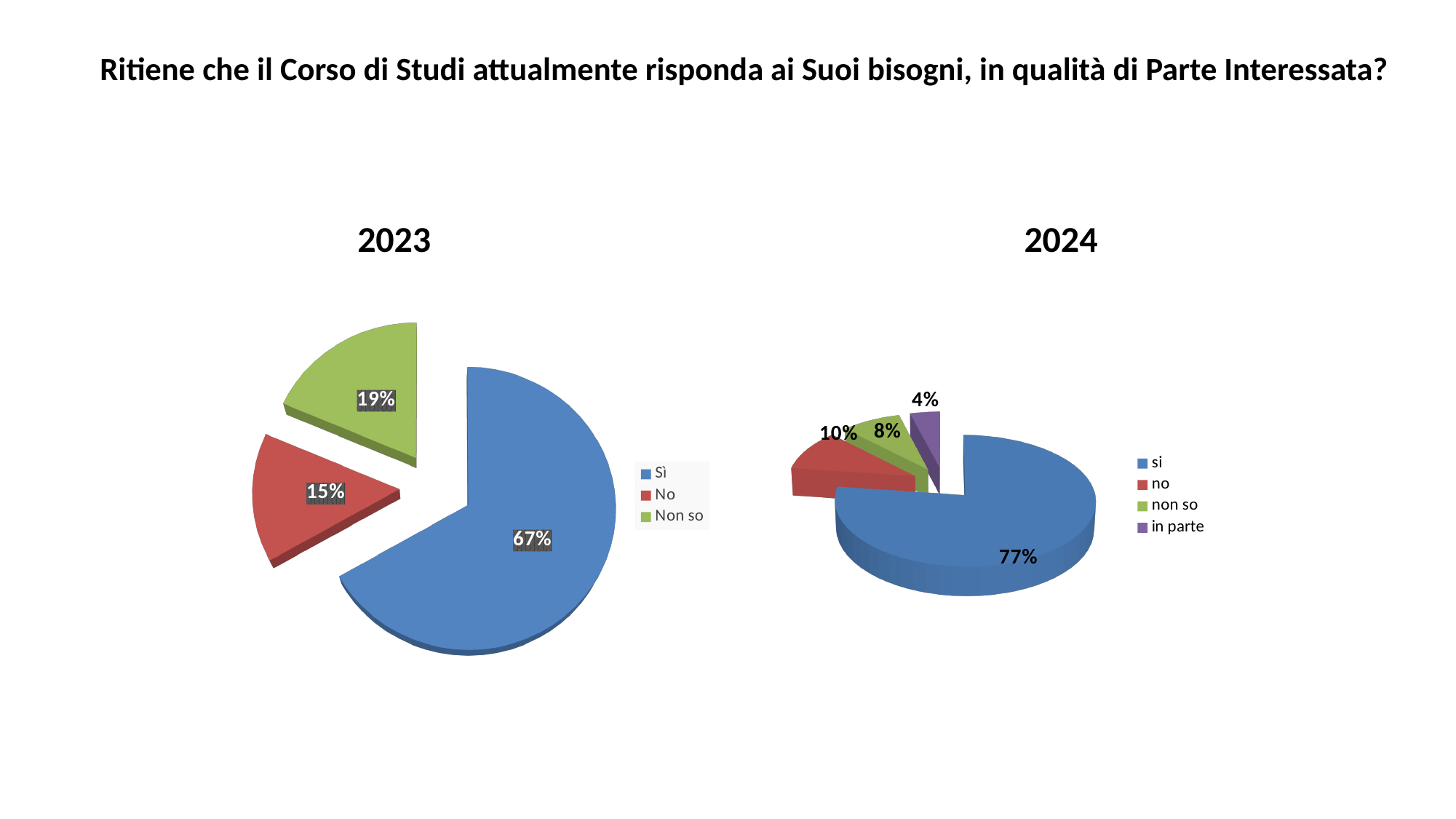
In the 2024 chart, what percentage of respondents answered 'in parte'? 4% In the 2023 chart, which response has the largest share? Sì In the 2023 chart, what percentage of respondents answered 'Non so'? 19% In the 2024 chart, which response has the smallest share? in parte What type of chart is the 2023 chart? pie chart In the 2023 chart, what percentage of respondents answered 'Sì'? 67% In the 2024 chart, what colour is the 'in parte' slice? purple How many entries does the legend of the 2023 chart list? 3 In the 2024 chart, what percentage of respondents answered 'no'? 10% In the 2023 chart, what is the difference in percentage points between 'Non so' and 'No'? 4 How many slices does the 2024 chart have? 4 In the 2024 chart, is the share for 'no' larger or smaller than the share for 'non so'? larger